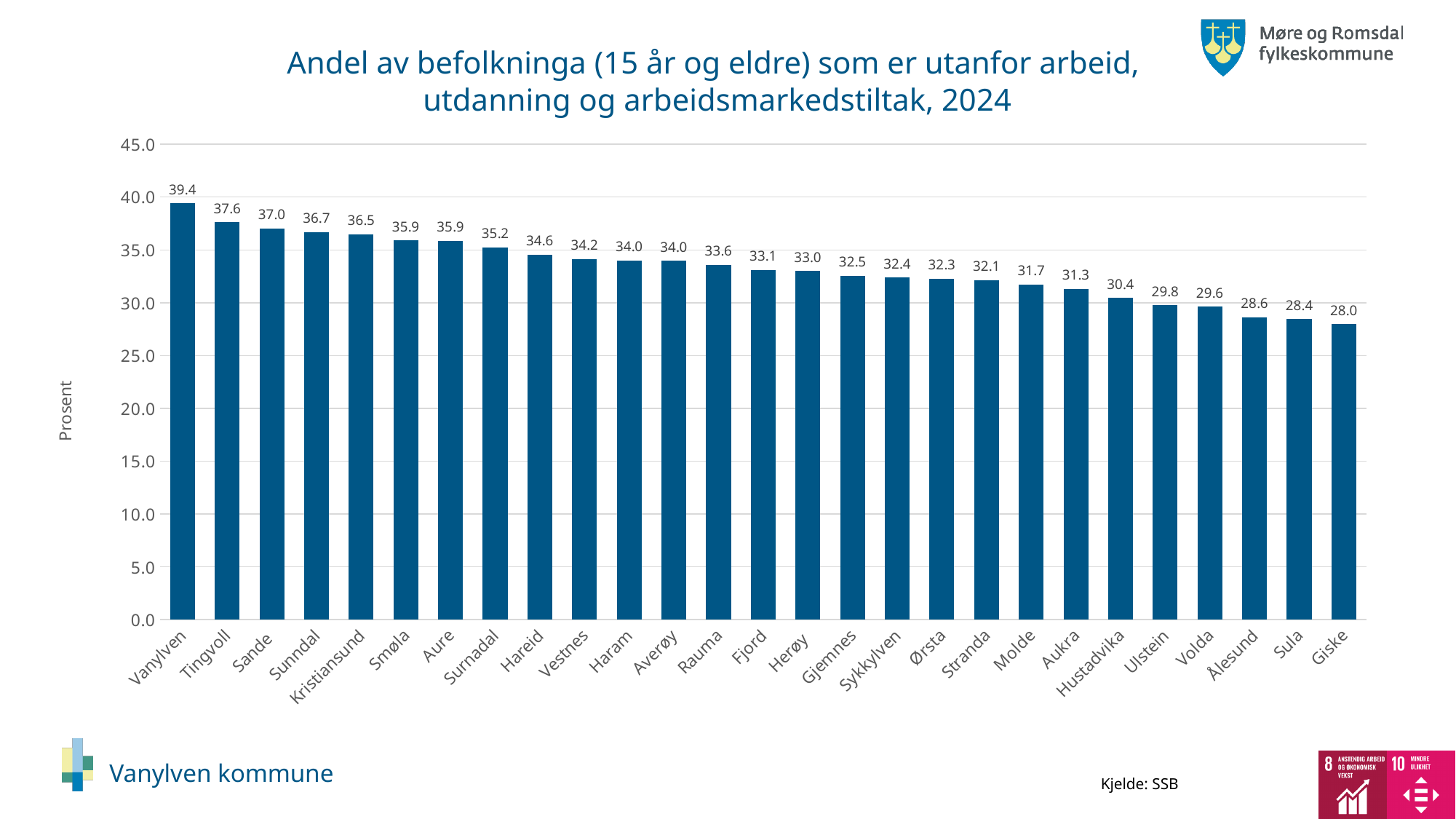
What is the value for Ålesund? 28.6 Is the value for Volda greater or less than 30.0? less What kind of chart is shown on the slide? bar chart Which municipality has the lowest value? Giske What is the difference between the values for Vanylven and Giske? 11.4 How many municipalities are shown on the chart? 27 What is the label on the vertical axis? Prosent What is the value for Molde? 31.7 Which has a larger value, Kristiansund or Hustadvika? Kristiansund Which municipality has the highest value? Vanylven What is the difference between the values for Tingvoll and Sande? 0.6 What is the value for Vanylven? 39.4